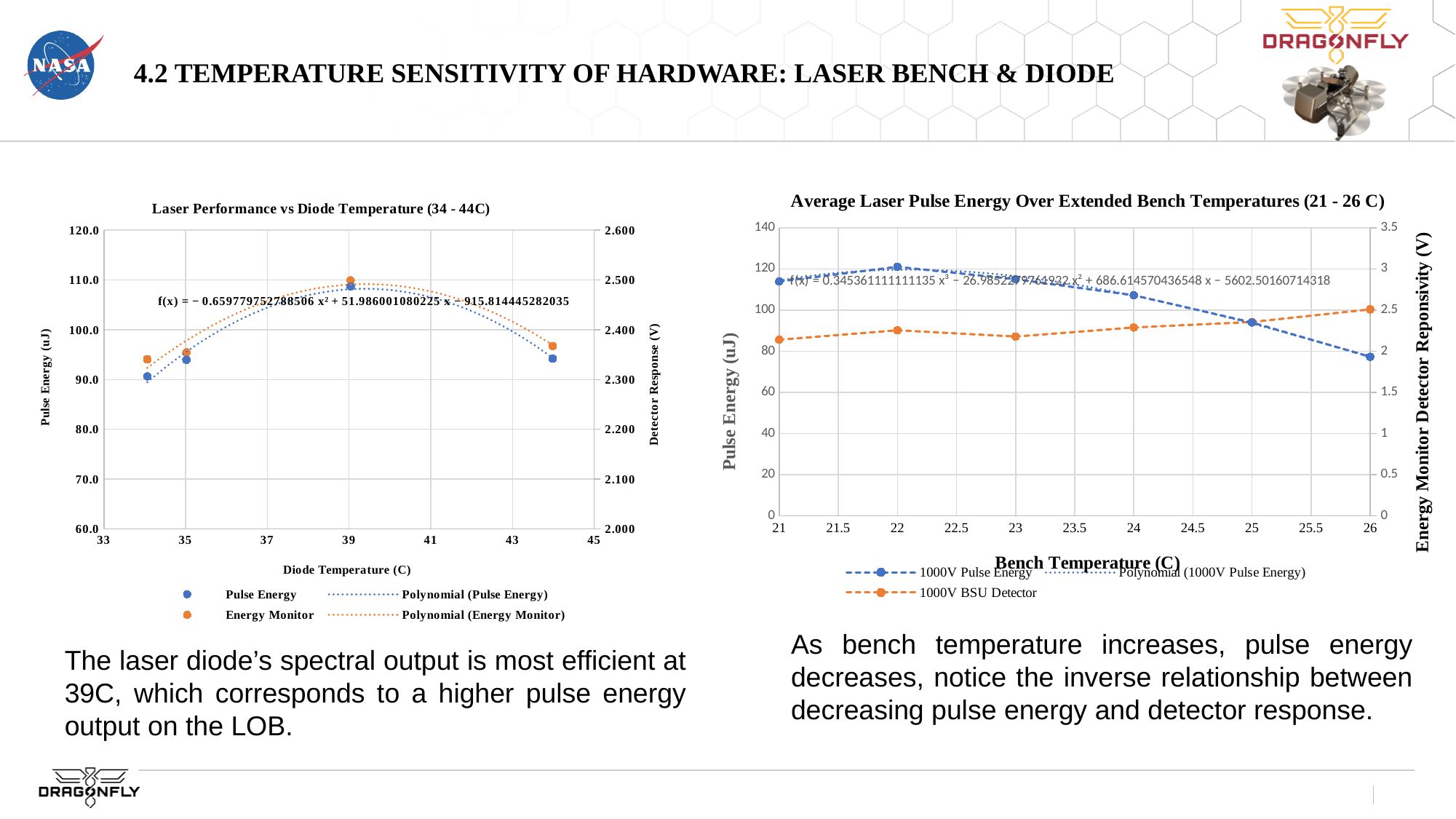
In the left chart, is the Pulse Energy at 34 C greater or less than 100.0? less In the right chart, at which bench temperature is the 1000V Pulse Energy highest? 22 In the right chart, which is larger at 26 C: the 1000V Pulse Energy or the 1000V Pulse Energy at 21 C? at 21 C What kind of chart is the left chart, 'Laser Performance vs Diode Temperature (34 - 44C)'? scatter chart In the right chart, how many data series does the legend list? 3 In the right chart, is the 1000V Pulse Energy at 21 C greater or less than 100? greater What kind of chart is the right chart, 'Average Laser Pulse Energy Over Extended Bench Temperatures (21 - 26 C)'? line chart In the right chart, at which bench temperature is the 1000V Pulse Energy lowest? 26 In the right chart, how many bench temperature points are plotted for the 1000V Pulse Energy series? 6 In the left chart, at which diode temperature is the Pulse Energy highest? 39 In the right chart, how does the 1000V Pulse Energy change from 22 C to 26 C? it falls What is the label of the left vertical axis of the right chart? Pulse Energy (uJ)